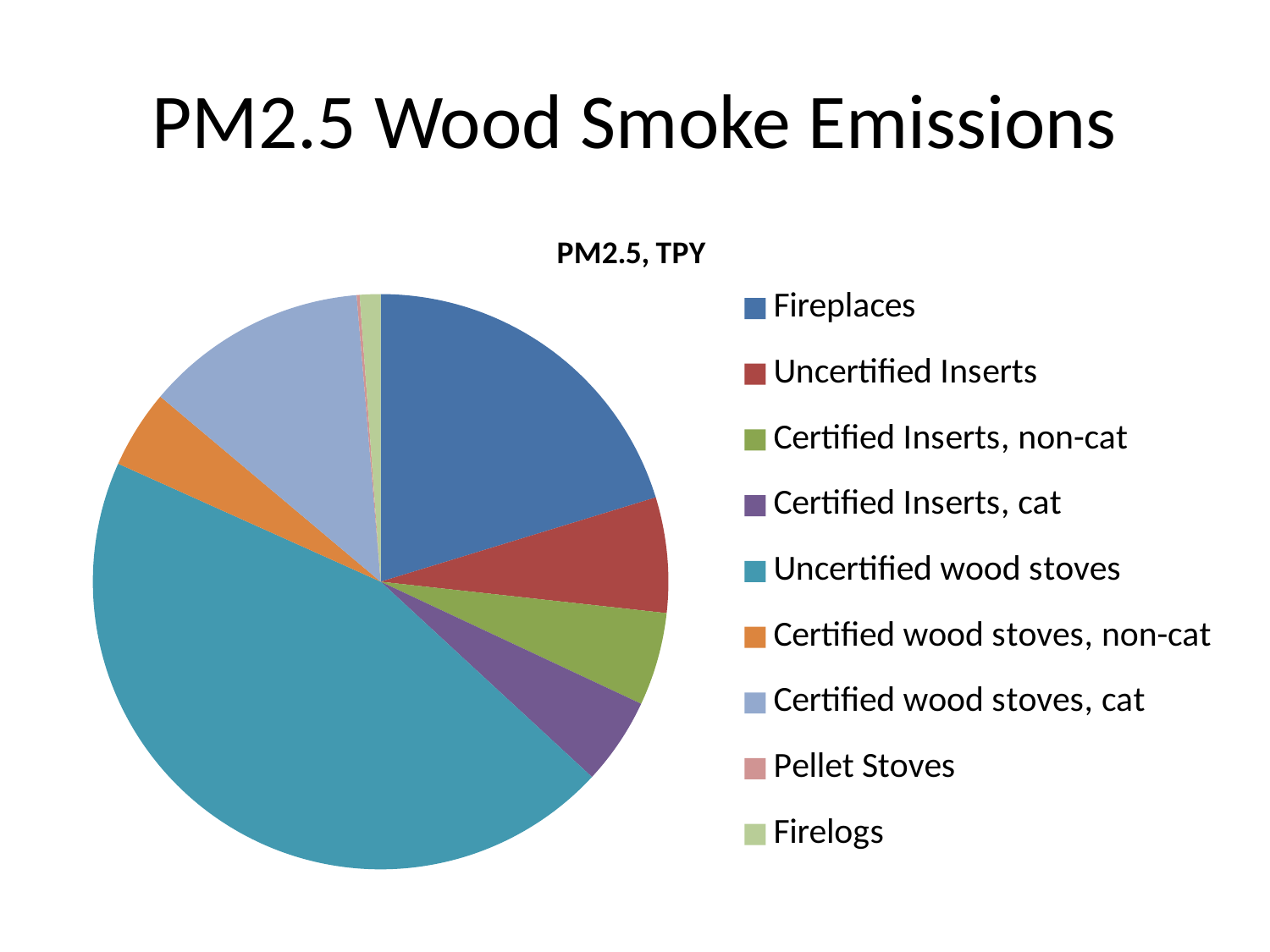
What kind of chart is shown on the slide? pie chart Which slice is larger, Fireplaces or Certified wood stoves, cat? Fireplaces How many categories does the pie chart have? 9 Which slice is larger, Firelogs or Uncertified wood stoves? Uncertified wood stoves What is the title of the chart? PM2.5, TPY Which slice is larger, Certified wood stoves, cat or Certified wood stoves, non-cat? Certified wood stoves, cat Which category has the largest slice of the pie? Uncertified wood stoves Which category is shown in orange in the pie chart? Certified wood stoves, non-cat Which category has the smallest slice of the pie? Pellet Stoves